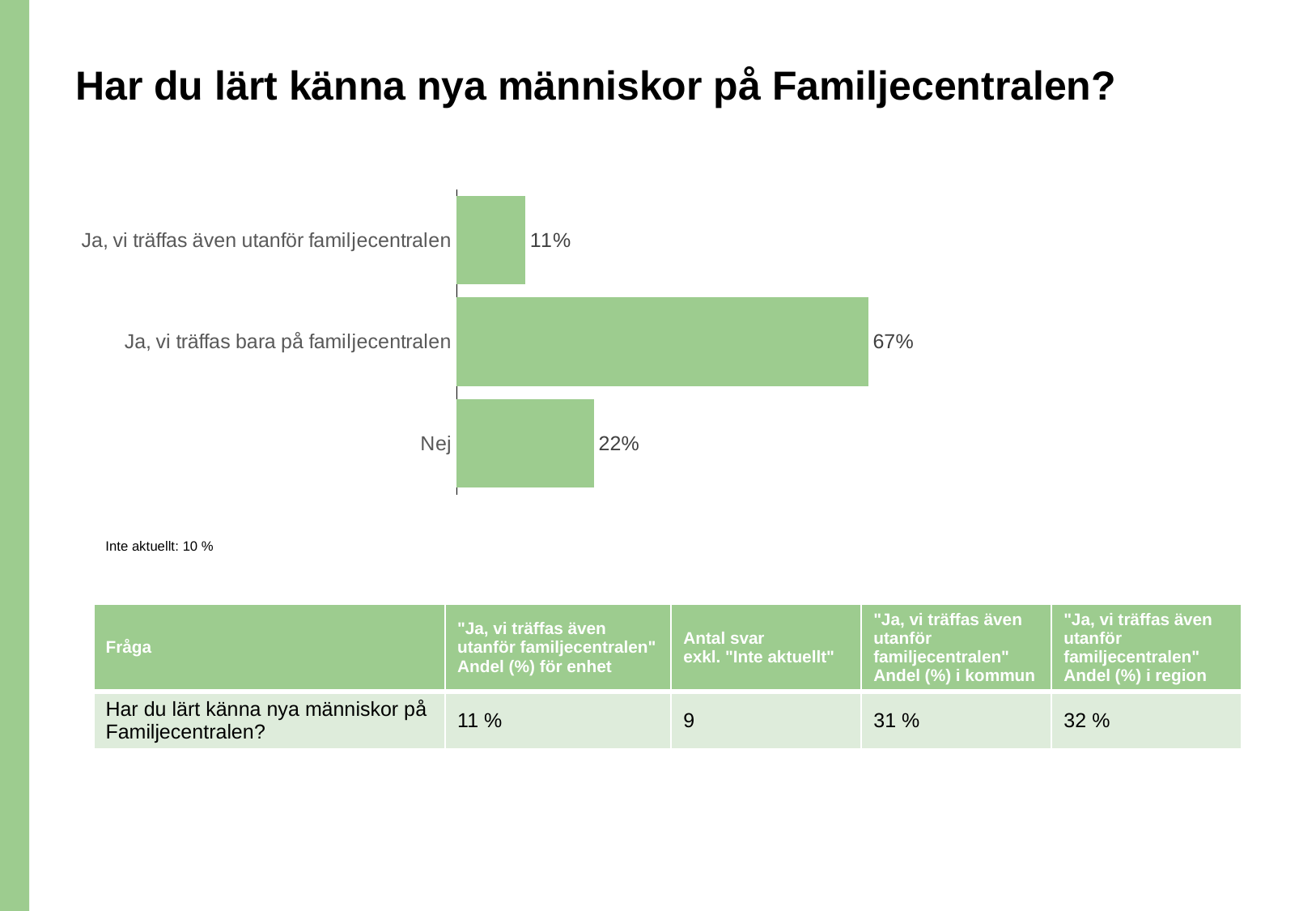
Which is larger, the value for "Nej" or the value for "Ja, vi träffas även utanför familjecentralen"? Nej What is the difference between the values for "Nej" and "Ja, vi träffas även utanför familjecentralen"? 11% What is the difference between the values for "Ja, vi träffas bara på familjecentralen" and "Nej"? 45% What is the value for "Ja, vi träffas bara på familjecentralen"? 67% What is the value for "Ja, vi träffas även utanför familjecentralen"? 11% How many categories are shown in the chart? 3 What is the value for "Nej"? 22% What is the total of the three values shown in the chart? 100% What colour are the bars in the chart? Green What kind of chart is shown on the slide? Bar chart Which category has the highest value? Ja, vi träffas bara på familjecentralen Which category has the lowest value? Ja, vi träffas även utanför familjecentralen